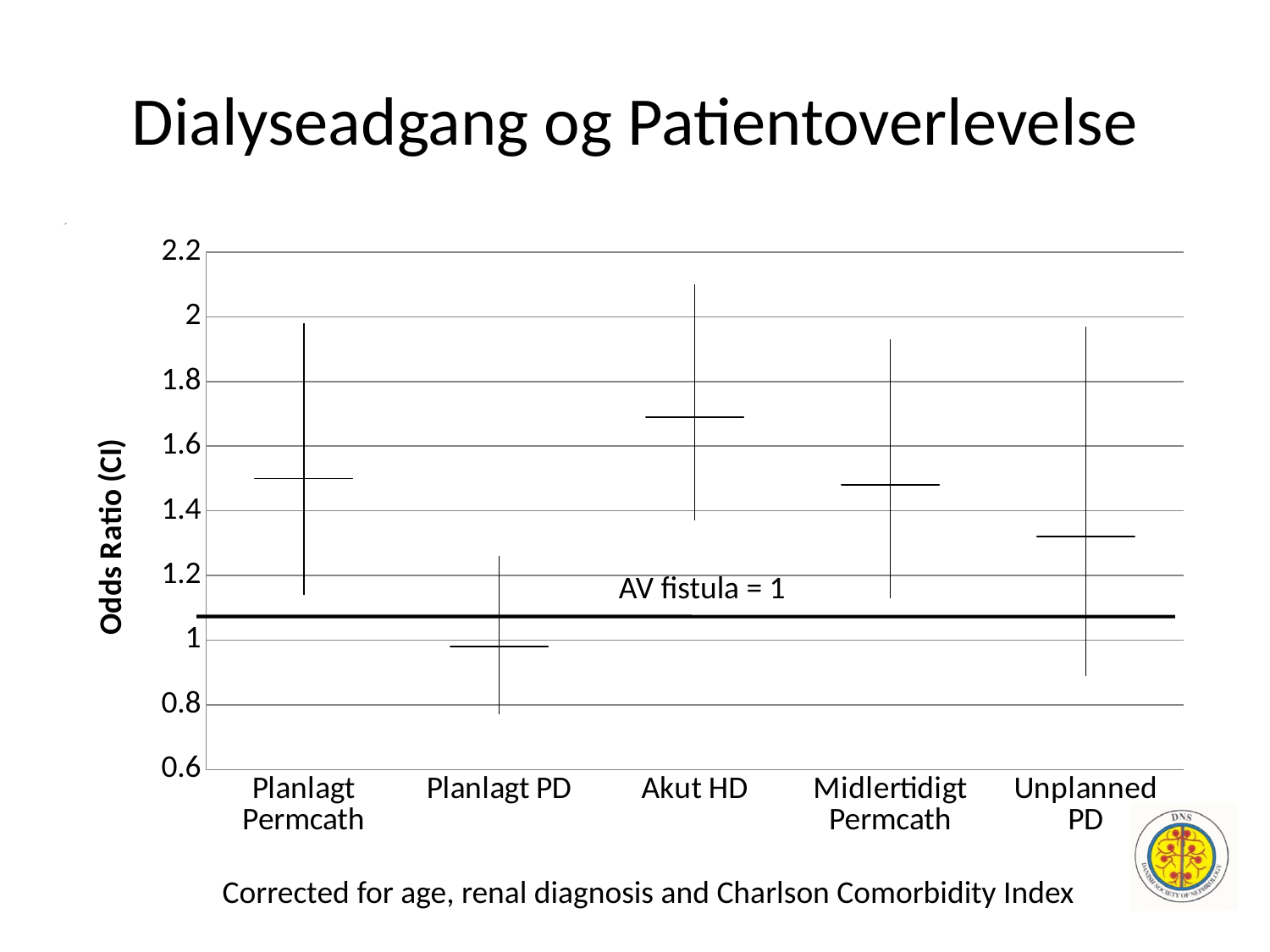
Which category has the lowest odds ratio in the chart? Planlagt PD Is the odds ratio for Midlertidigt Permcath greater or less than 1.4? greater Which category has the highest odds ratio in the chart? Akut HD What does the horizontal reference line across the chart represent, according to its label? AV fistula = 1 Is the odds ratio for Unplanned PD greater or less than 1.2? greater Is the odds ratio for Akut HD greater or less than 1.6? greater Which has the larger odds ratio, Akut HD or Planlagt PD? Akut HD What is the label of the y axis of the chart? Odds Ratio (CI) How many dialysis access categories are shown on the x axis of the chart? 5 Which has the larger odds ratio, Planlagt Permcath or Unplanned PD? Planlagt Permcath